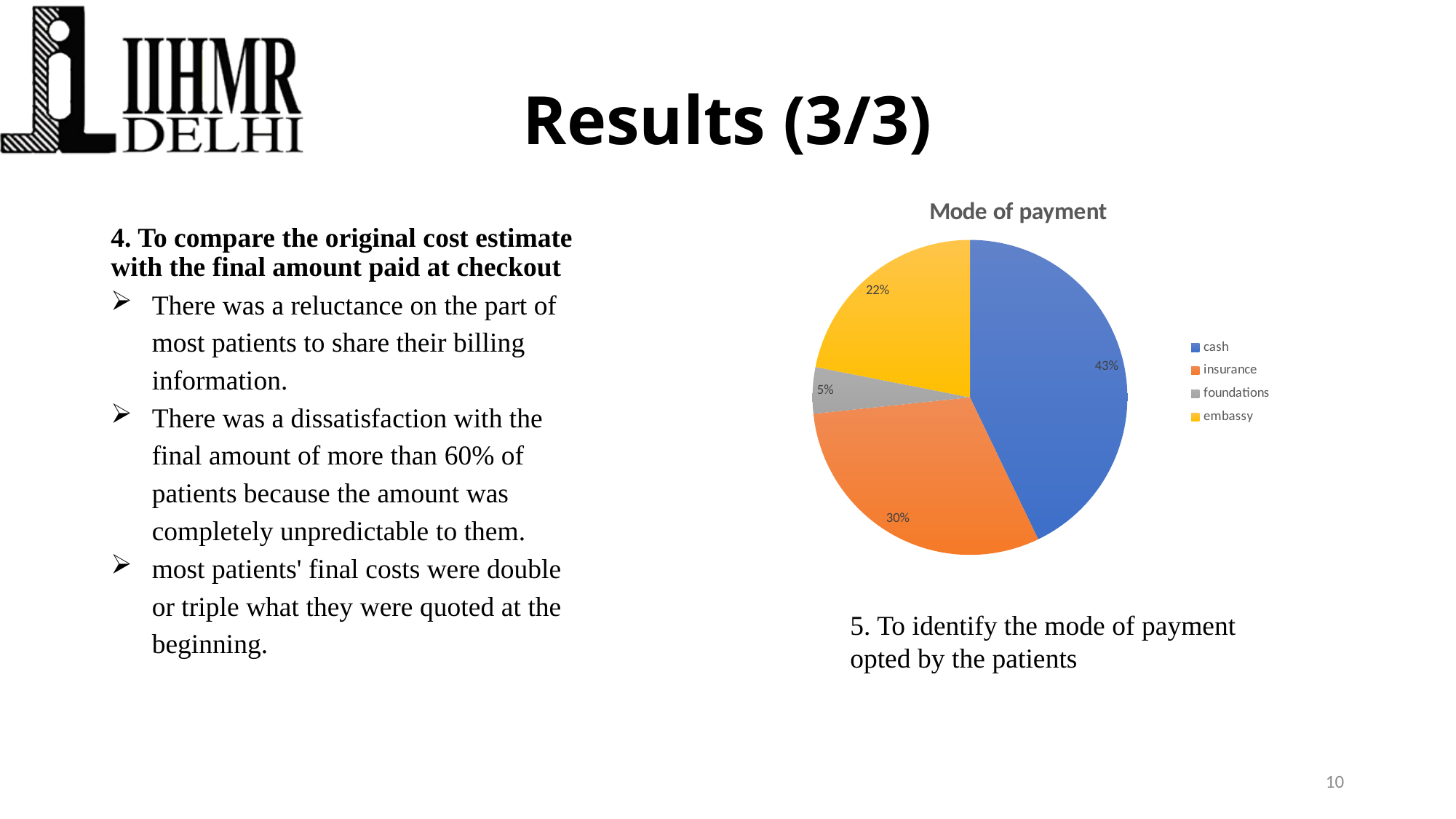
What share of the pie does embassy account for? 22% What is the title of the chart? Mode of payment What share of the pie does insurance account for? 30% How many slices does the pie chart have? 4 What share of the pie does foundations account for? 5% What is the difference in percentage points between the cash and insurance shares? 13% Which colour represents embassy in the legend? yellow What type of chart is shown on the slide? pie chart Which has a larger share, embassy or insurance? insurance Which mode of payment has the smallest share? foundations Which mode of payment has the largest share? cash What share of the pie does cash account for? 43%